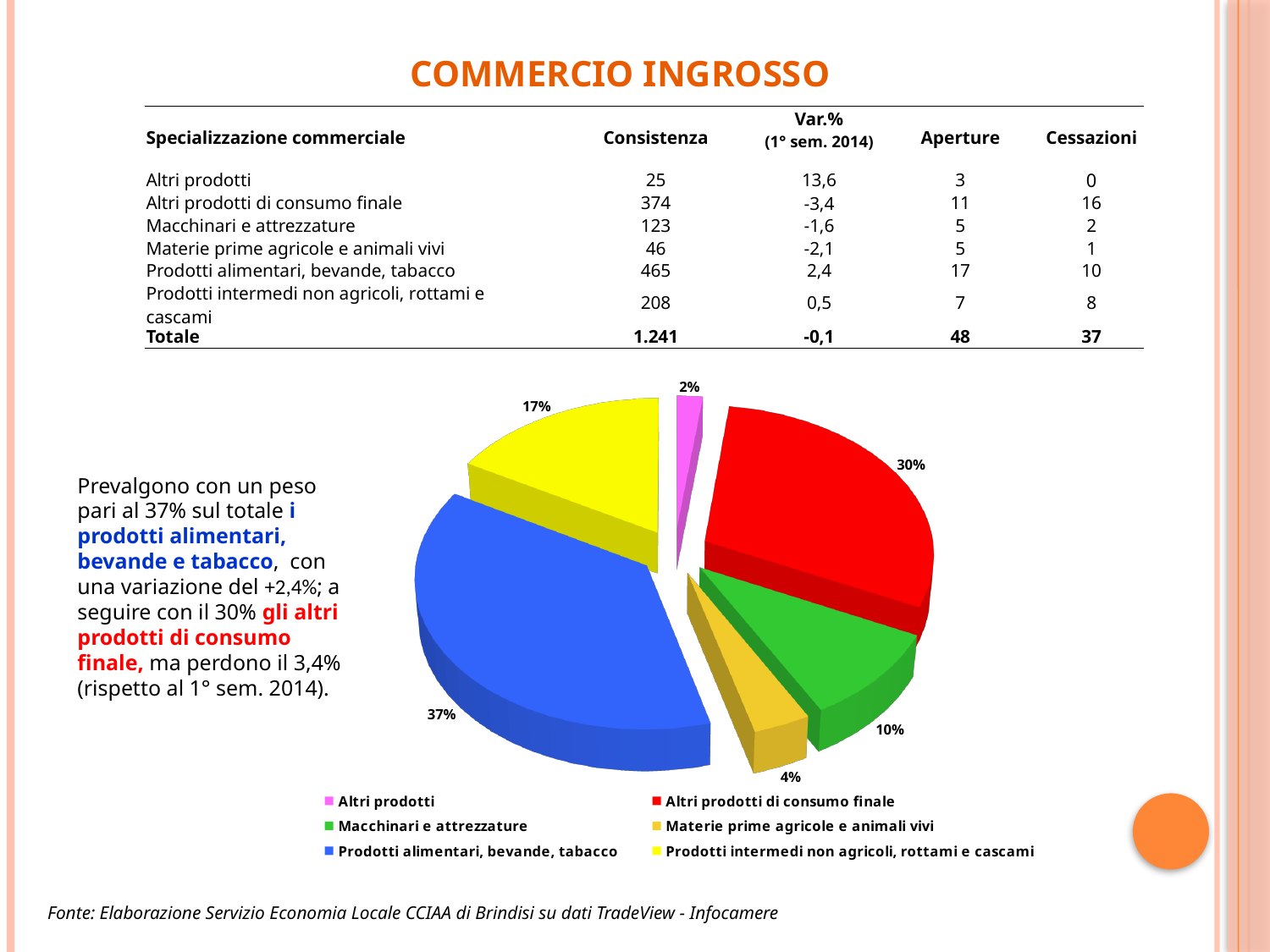
What is the difference in percentage points between the "Prodotti alimentari, bevande, tabacco" slice and the "Altri prodotti di consumo finale" slice? 7 What share of the pie does "Prodotti alimentari, bevande, tabacco" have? 37% How many slices does the pie chart have? 6 What share of the pie does "Altri prodotti di consumo finale" have? 30% What share of the pie does "Materie prime agricole e animali vivi" have? 4% What kind of chart is shown on the slide? pie chart Which slice is larger: "Macchinari e attrezzature" or "Materie prime agricole e animali vivi"? Macchinari e attrezzature Which category has the largest slice of the pie? Prodotti alimentari, bevande, tabacco What colour is the slice for "Altri prodotti di consumo finale" in the pie chart? red Which category has the smallest slice of the pie? Altri prodotti